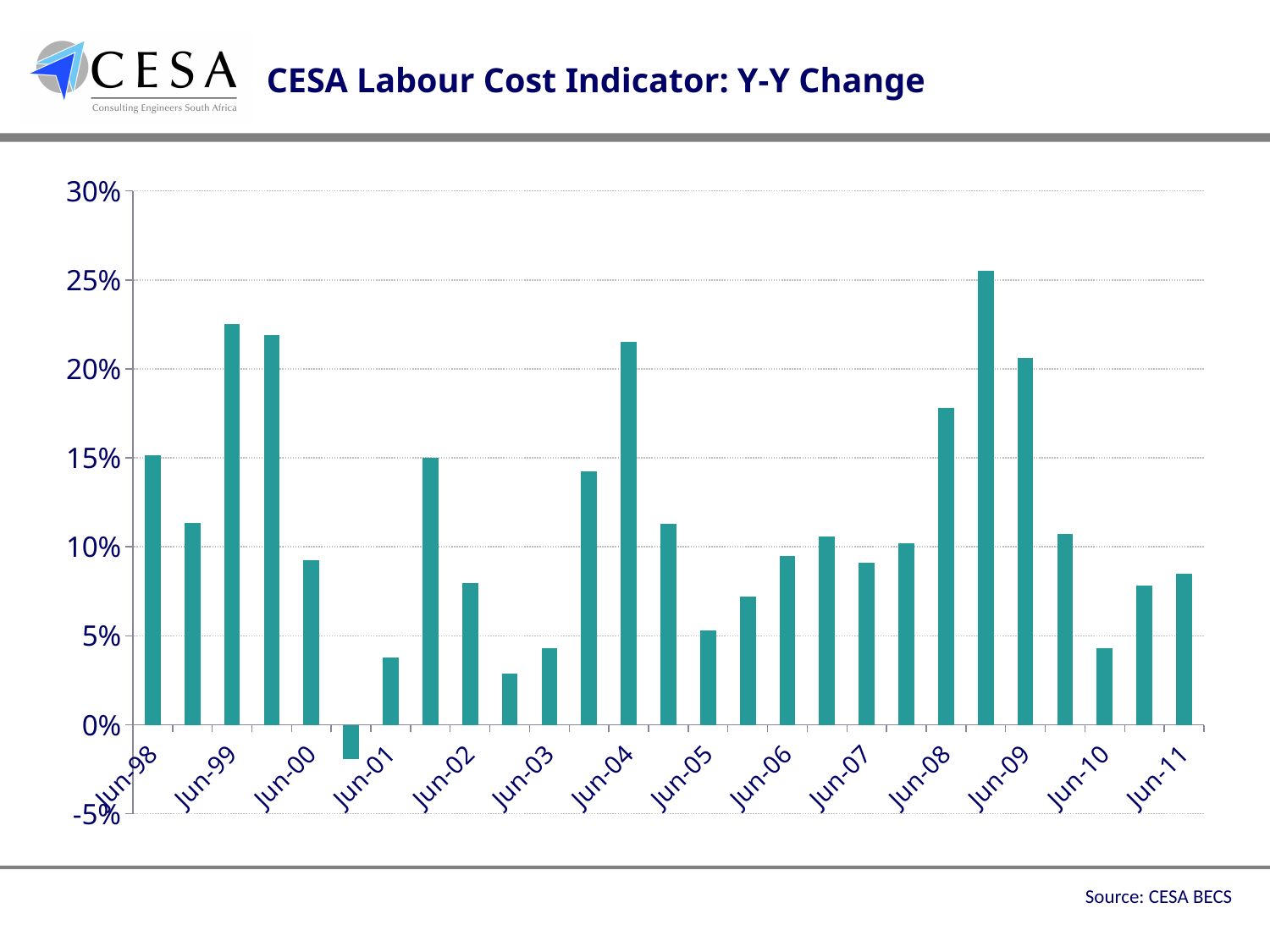
Is the value for Jun-10 greater or less than 5%? less Is the value for Jun-01 greater or less than 5%? less Is the value for Jun-04 greater or less than 20%? greater What kind of chart is shown on the slide? bar chart How many labels are shown on the x axis of the chart? 14 Which is larger, the value for Jun-99 or the value for Jun-00? Jun-99 How many bars in the chart fall below 0%? 1 Which is larger, the value for Jun-04 or the value for Jun-05? Jun-04 What is the title of the chart? CESA Labour Cost Indicator: Y-Y Change